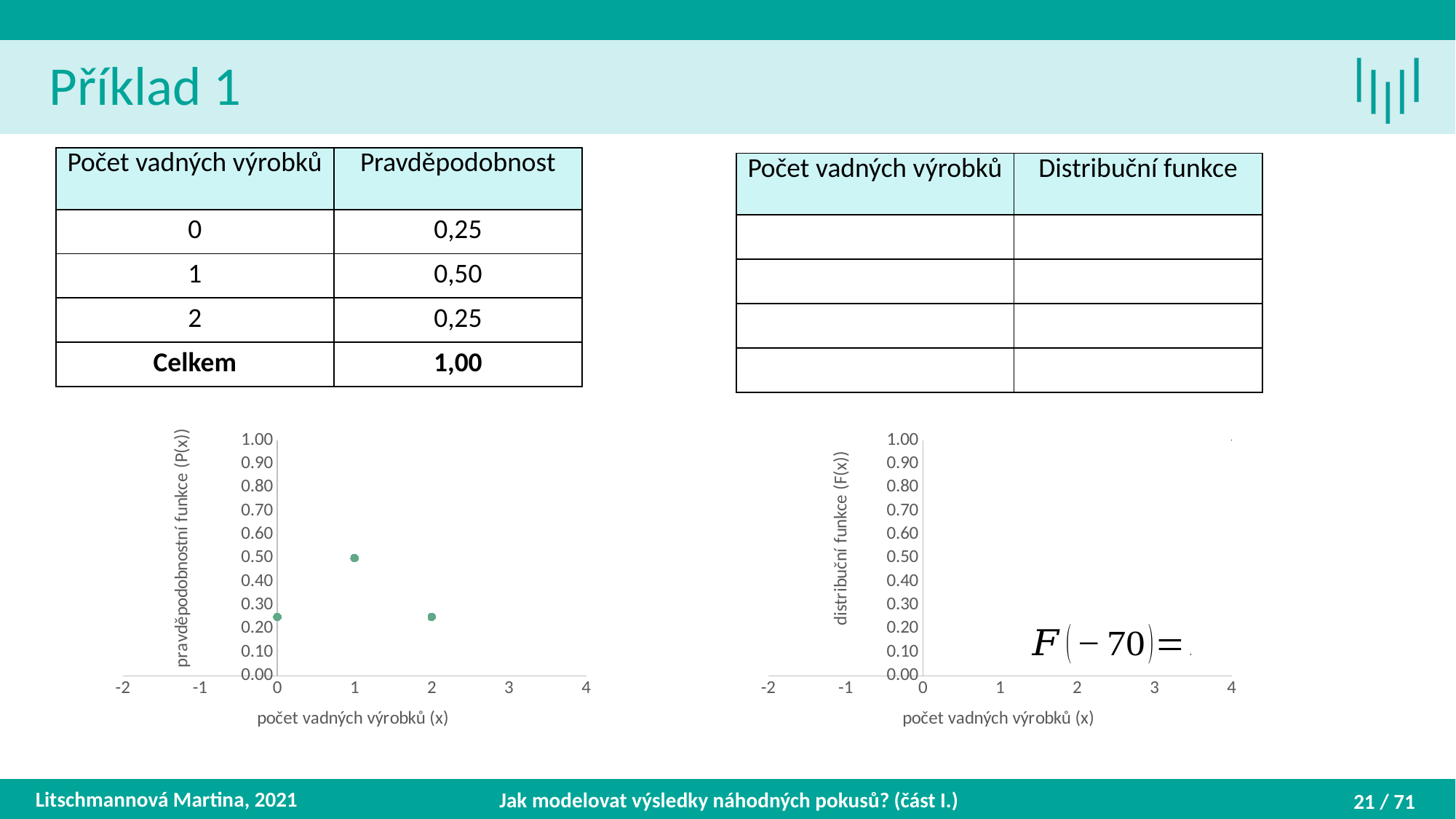
On the left chart (pravděpodobnostní funkce), is the value at x = 0 greater or less than 0.20? greater On the left chart, what is the x-axis title? počet vadných výrobků (x) On the left chart (pravděpodobnostní funkce), at which value of x is the plotted point highest? 1 On the left chart (pravděpodobnostní funkce), is the value at x = 2 greater or less than 0.30? less On the left chart (pravděpodobnostní funkce), do the values rise or fall from x = 1 to x = 2? fall What kind of chart is the left chart (pravděpodobnostní funkce)? scatter chart On the right chart (distribuční funkce), what is the highest value shown on the y axis? 1.00 On the left chart (pravděpodobnostní funkce), which has the larger value: x = 1 or x = 2? x = 1 On the left chart (pravděpodobnostní funkce), how many data points are plotted? 3 On the right chart, what is the y-axis title? distribuční funkce (F(x)) On the left chart (pravděpodobnostní funkce), what is the value of P(x) at x = 1? 0.50